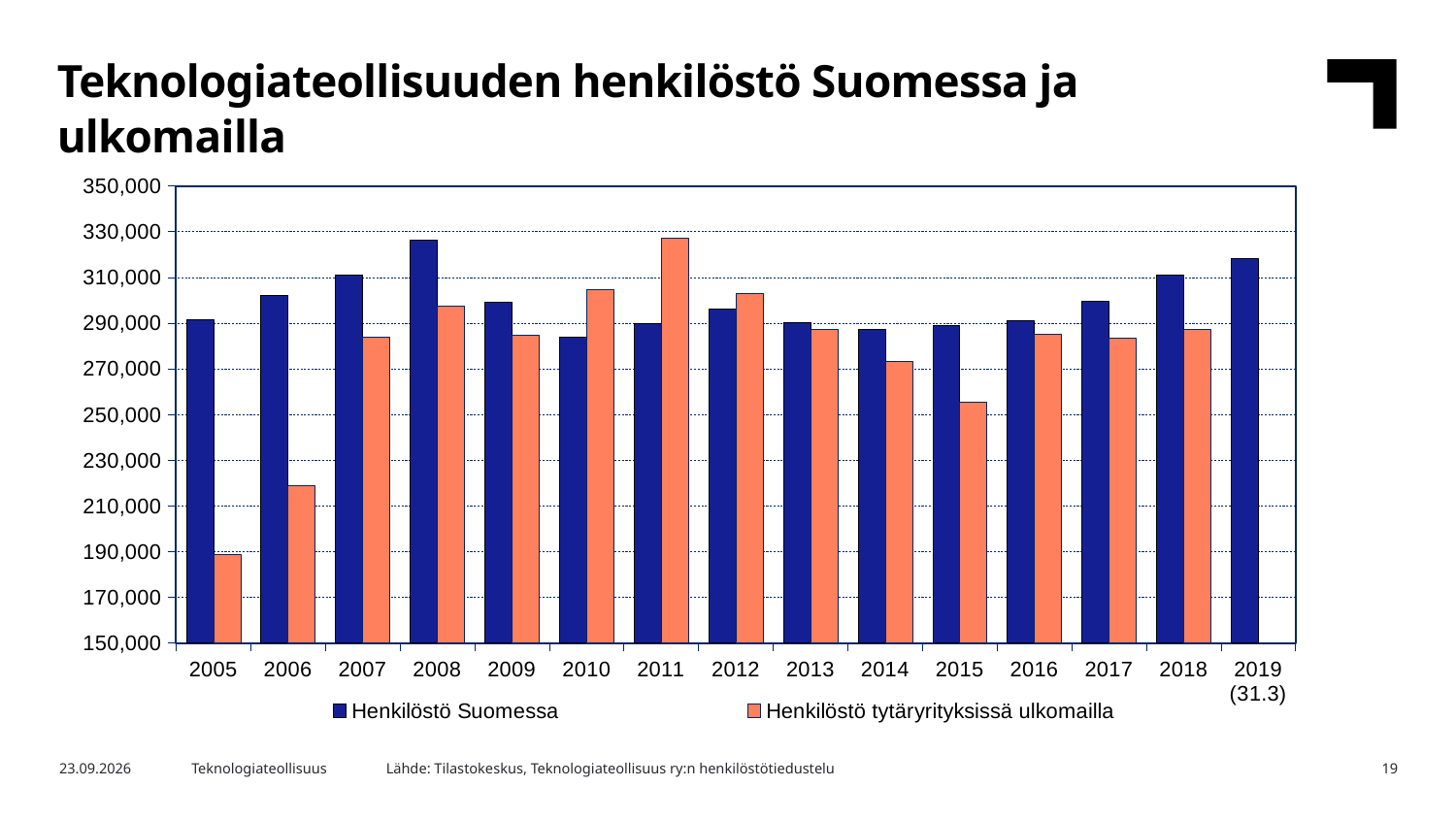
Does the value for Henkilöstö tytäryrityksissä ulkomailla rise or fall from 2005 to 2011? rise How many years are shown on the x axis? 15 In which year is the value for Henkilöstö tytäryrityksissä ulkomailla lowest? 2005 In which year is the value for Henkilöstö Suomessa highest? 2008 Is the value for Henkilöstö tytäryrityksissä ulkomailla in 2006 greater or less than 210,000? greater In which year is the value for Henkilöstö tytäryrityksissä ulkomailla highest? 2011 What kind of chart is shown on the slide? Bar chart How many series does the legend list? 2 In 2005, which series has the larger value: Henkilöstö Suomessa or Henkilöstö tytäryrityksissä ulkomailla? Henkilöstö Suomessa Is the value for Henkilöstö Suomessa in 2019 (31.3) greater or less than 310,000? greater In 2011, which series has the larger value: Henkilöstö Suomessa or Henkilöstö tytäryrityksissä ulkomailla? Henkilöstö tytäryrityksissä ulkomailla Is the value for Henkilöstö tytäryrityksissä ulkomailla in 2015 greater or less than 270,000? less